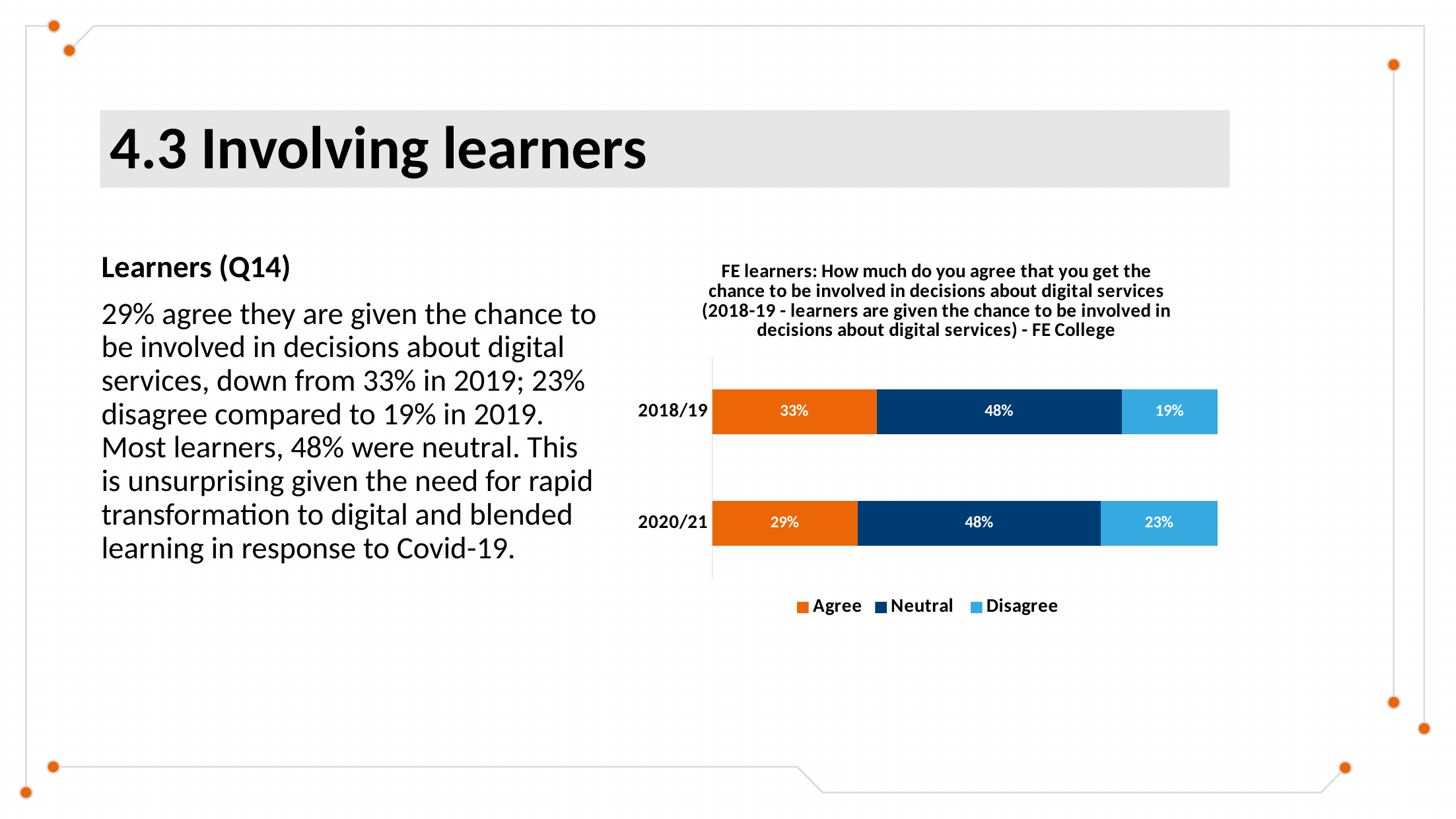
By how many percentage points did the Disagree share change from 2018/19 to 2020/21? 4% What percentage of FE learners agreed in 2020/21? 29% What type of chart is shown on the slide? Stacked bar chart Which response category is the smallest in the 2018/19 bar? Disagree How many year categories are shown on the chart? 2 Which year had the higher Agree percentage, 2018/19 or 2020/21? 2018/19 Which response category is the largest in the 2020/21 bar? Neutral How many series does the legend list? 3 What percentage of FE learners disagreed in 2020/21? 23% What percentage of FE learners were neutral in 2018/19? 48% What is the difference between the Agree percentages for 2018/19 and 2020/21? 4% What percentage of FE learners disagreed in 2018/19? 19%